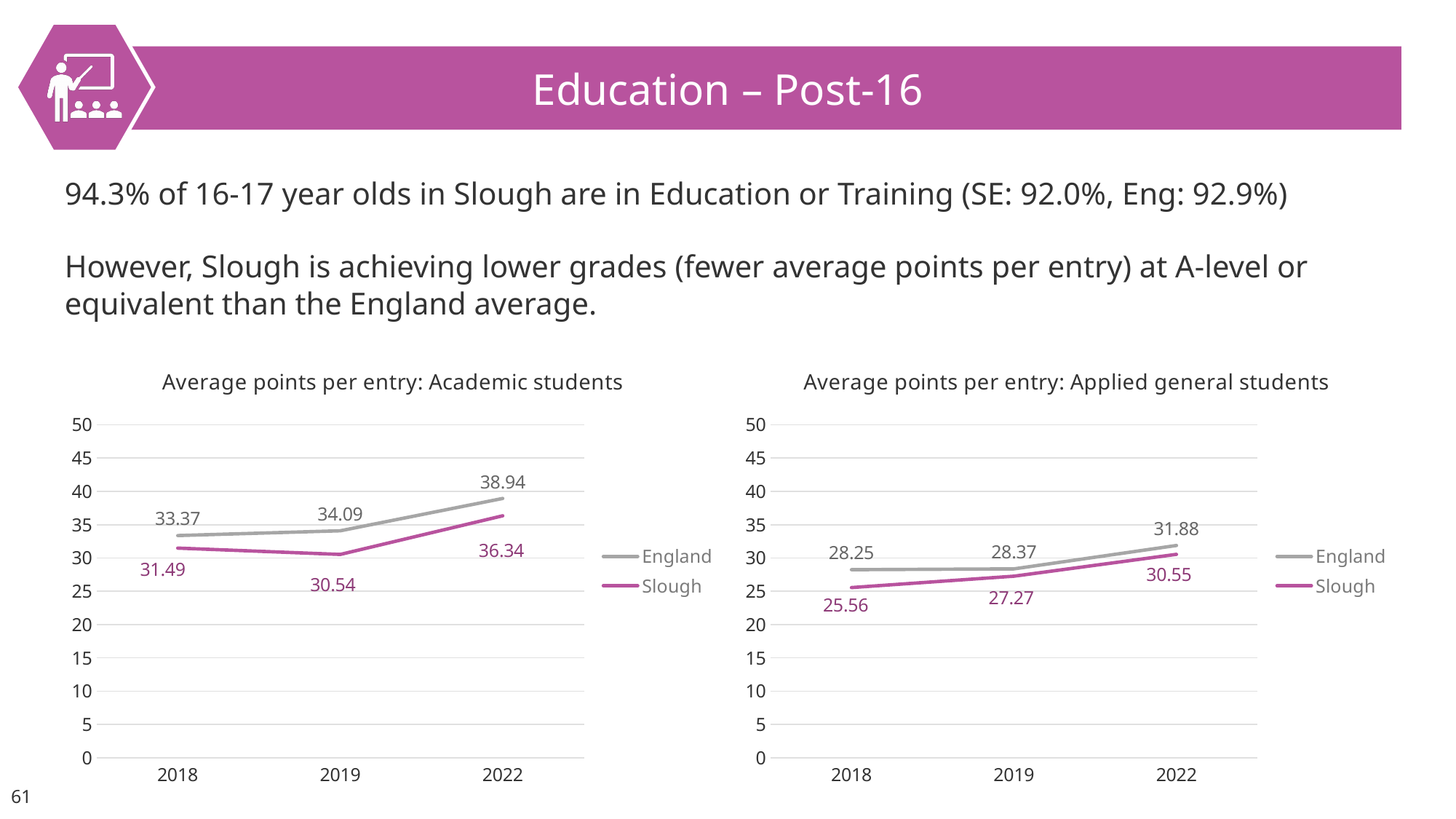
In the 'Average points per entry: Applied general students' chart, what is the value for England in 2019? 28.37 In the 'Average points per entry: Academic students' chart, what is the difference between England and Slough in 2022? 2.60 In the 'Average points per entry: Academic students' chart, what is the value for England in 2022? 38.94 In the 'Average points per entry: Applied general students' chart, what is the value for Slough in 2018? 25.56 In the 'Average points per entry: Academic students' chart, in which year is the Slough value lowest? 2019 In the 'Average points per entry: Applied general students' chart, in which year is the England value highest? 2022 In the 'Average points per entry: Applied general students' chart, how many series does the legend list? 2 What kind of chart is 'Average points per entry: Academic students'? Line chart In the 'Average points per entry: Academic students' chart, which is larger in 2018: England or Slough? England In the 'Average points per entry: Academic students' chart, what is the value for Slough in 2019? 30.54 In the 'Average points per entry: Applied general students' chart, what is the difference between England and Slough in 2018? 2.69 In the 'Average points per entry: Applied general students' chart, does the Slough value rise or fall from 2018 to 2022? Rise